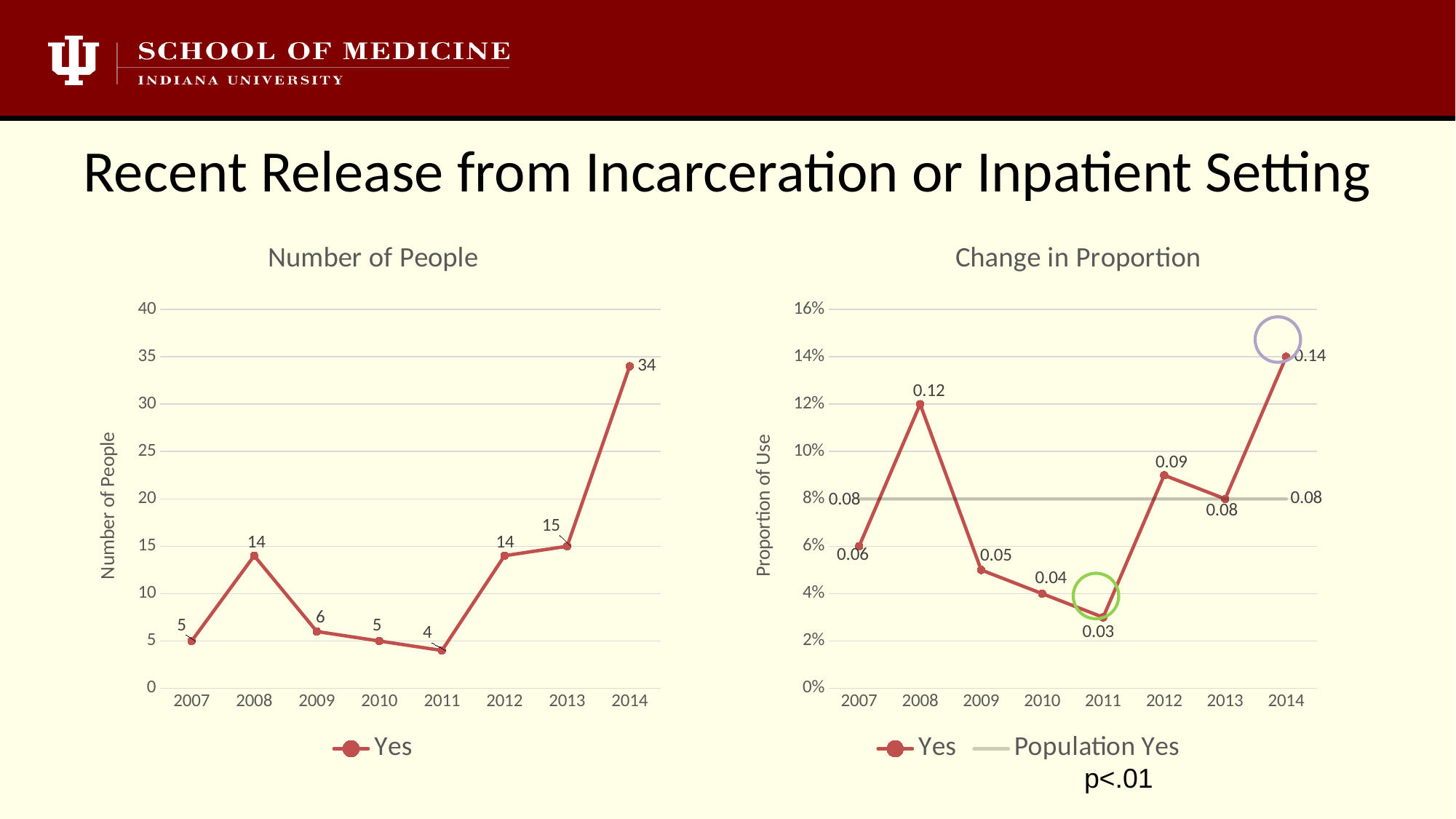
In the 'Change in Proportion' chart, how many series does the legend list? 2 What kind of chart is the 'Number of People' chart? Line chart In the 'Number of People' chart, what is the value for 2014? 34 In the 'Change in Proportion' chart, what is the value of the Yes series for 2008? 0.12 What is the y-axis label of the 'Change in Proportion' chart? Proportion of Use In the 'Change in Proportion' chart, what is the value of the Population Yes line? 0.08 In the 'Number of People' chart, how many years are plotted on the x axis? 8 In the 'Number of People' chart, which year has the lowest value? 2011 In the 'Change in Proportion' chart, which year has the highest Yes value? 2014 In the 'Change in Proportion' chart, which year has the lowest Yes value? 2011 In the 'Change in Proportion' chart, is the Yes value for 2012 larger or smaller than the Yes value for 2009? larger In the 'Number of People' chart, what is the difference between the values for 2014 and 2013? 19